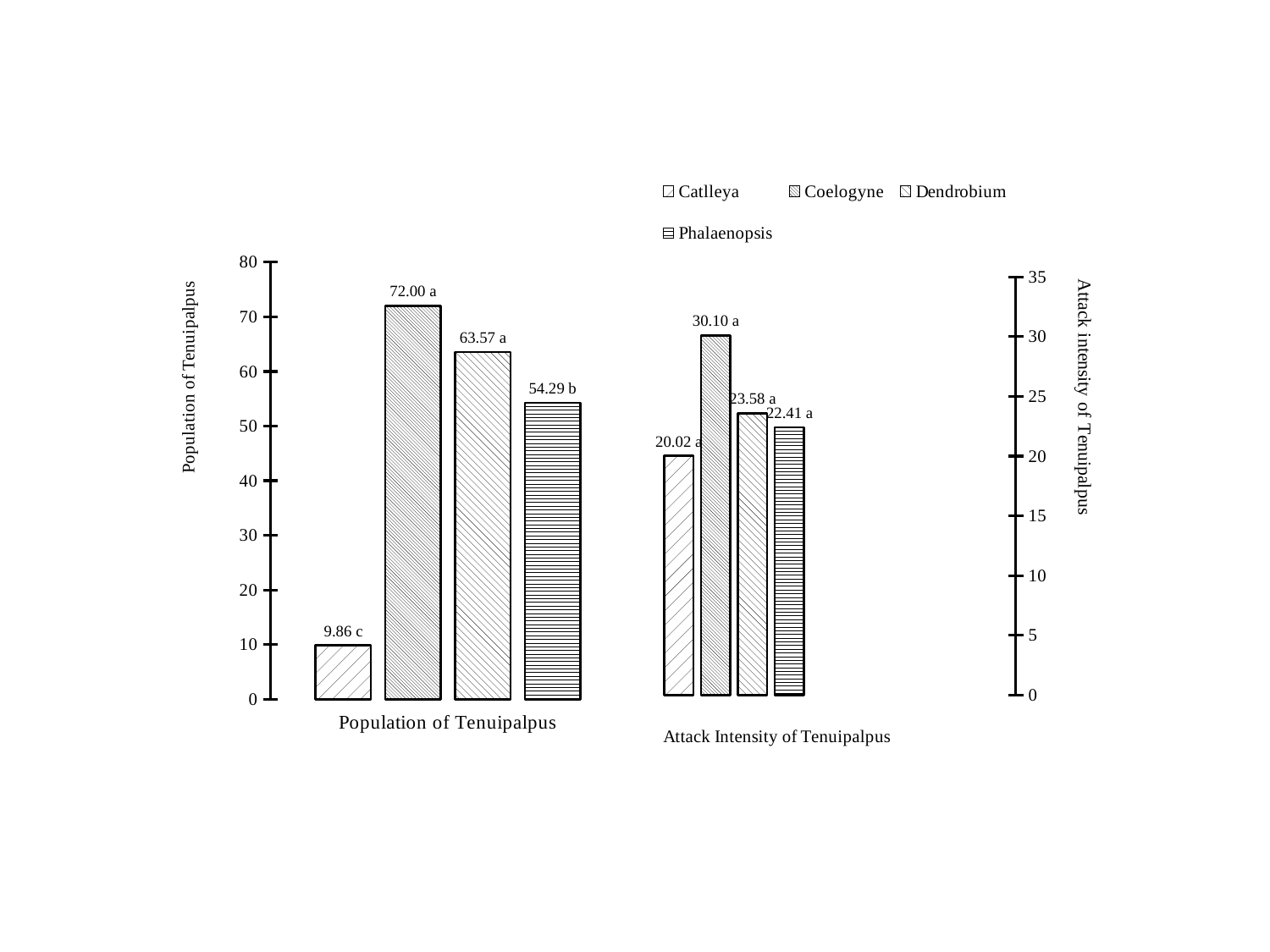
What kind of chart is shown on the slide? Bar chart What is the data label on the Catlleya bar in the Attack Intensity of Tenuipalpus group? 20.02 a How many series does the legend list? 4 Which series has the highest value in the Population of Tenuipalpus group? Coelogyne What is the data label on the Phalaenopsis bar in the Population of Tenuipalpus group? 54.29 b What is the data label on the Coelogyne bar in the Population of Tenuipalpus group? 72.00 a Which series has the lowest value in the Population of Tenuipalpus group? Catlleya What is the data label on the Dendrobium bar in the Attack Intensity of Tenuipalpus group? 23.58 a In the Attack Intensity of Tenuipalpus group, which is larger: Dendrobium or Phalaenopsis? Dendrobium What is the difference between the Coelogyne and Catlleya values in the Attack Intensity of Tenuipalpus group? 10.08 What is the difference between the Coelogyne and Catlleya values in the Population of Tenuipalpus group? 62.14 Which series has the highest value in the Attack Intensity of Tenuipalpus group? Coelogyne